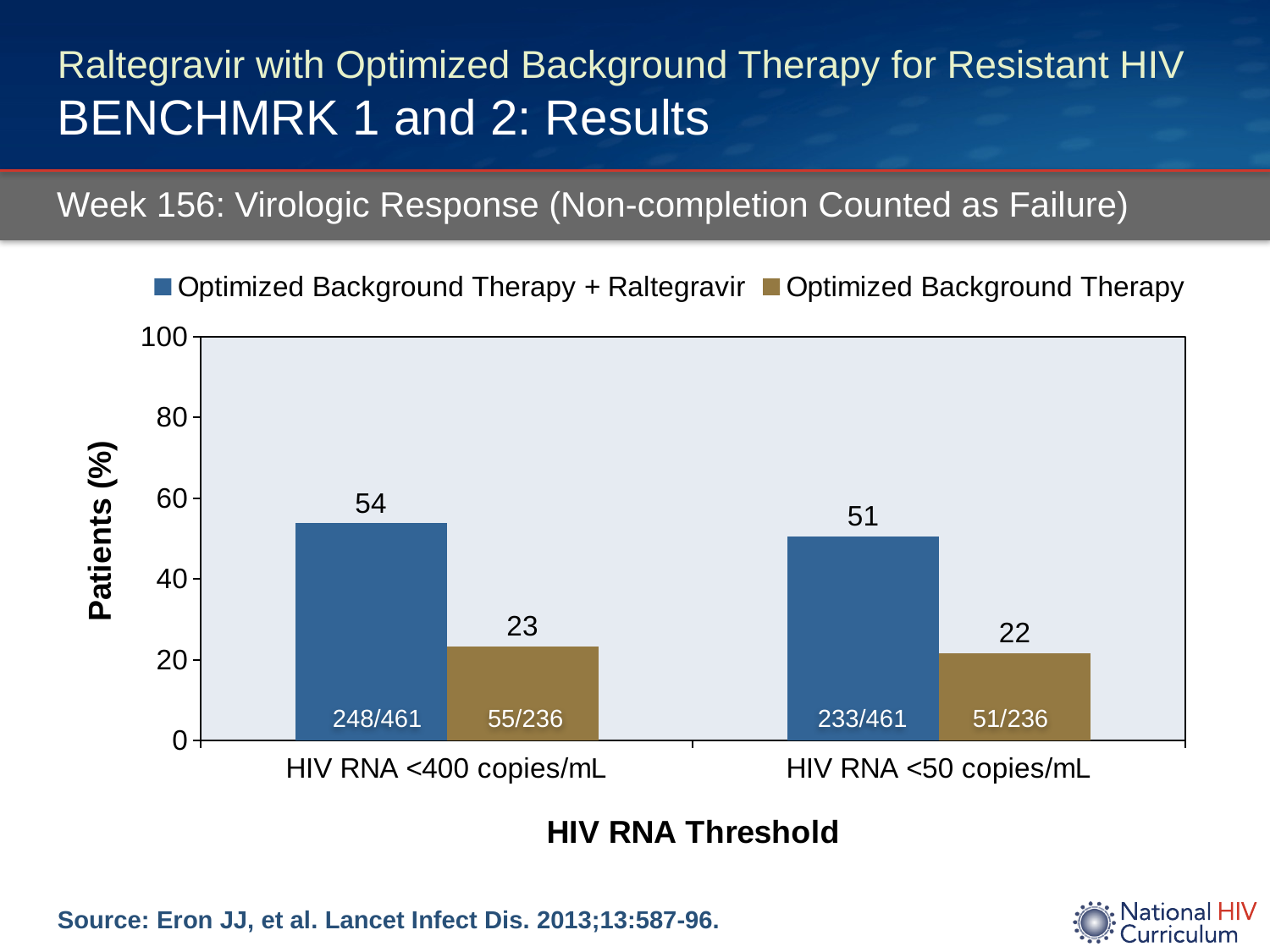
What kind of chart is shown on the slide? Bar chart Which bar has the highest value on the chart? Optimized Background Therapy + Raltegravir, HIV RNA <400 copies/mL What is the value for Optimized Background Therapy at the HIV RNA <400 copies/mL threshold? 23 What is the difference between the two series at the HIV RNA <400 copies/mL threshold? 31 What is the difference between the two series at the HIV RNA <50 copies/mL threshold? 29 How many series does the legend list? 2 What percentage of patients on Optimized Background Therapy + Raltegravir achieved HIV RNA <400 copies/mL? 54 What percentage of patients on Optimized Background Therapy alone achieved HIV RNA <50 copies/mL? 22 Which series has the larger value at HIV RNA <50 copies/mL? Optimized Background Therapy + Raltegravir How many HIV RNA threshold categories are shown on the x axis? 2 Which bar has the lowest value on the chart? Optimized Background Therapy, HIV RNA <50 copies/mL What is the value for Optimized Background Therapy + Raltegravir at the HIV RNA <50 copies/mL threshold? 51